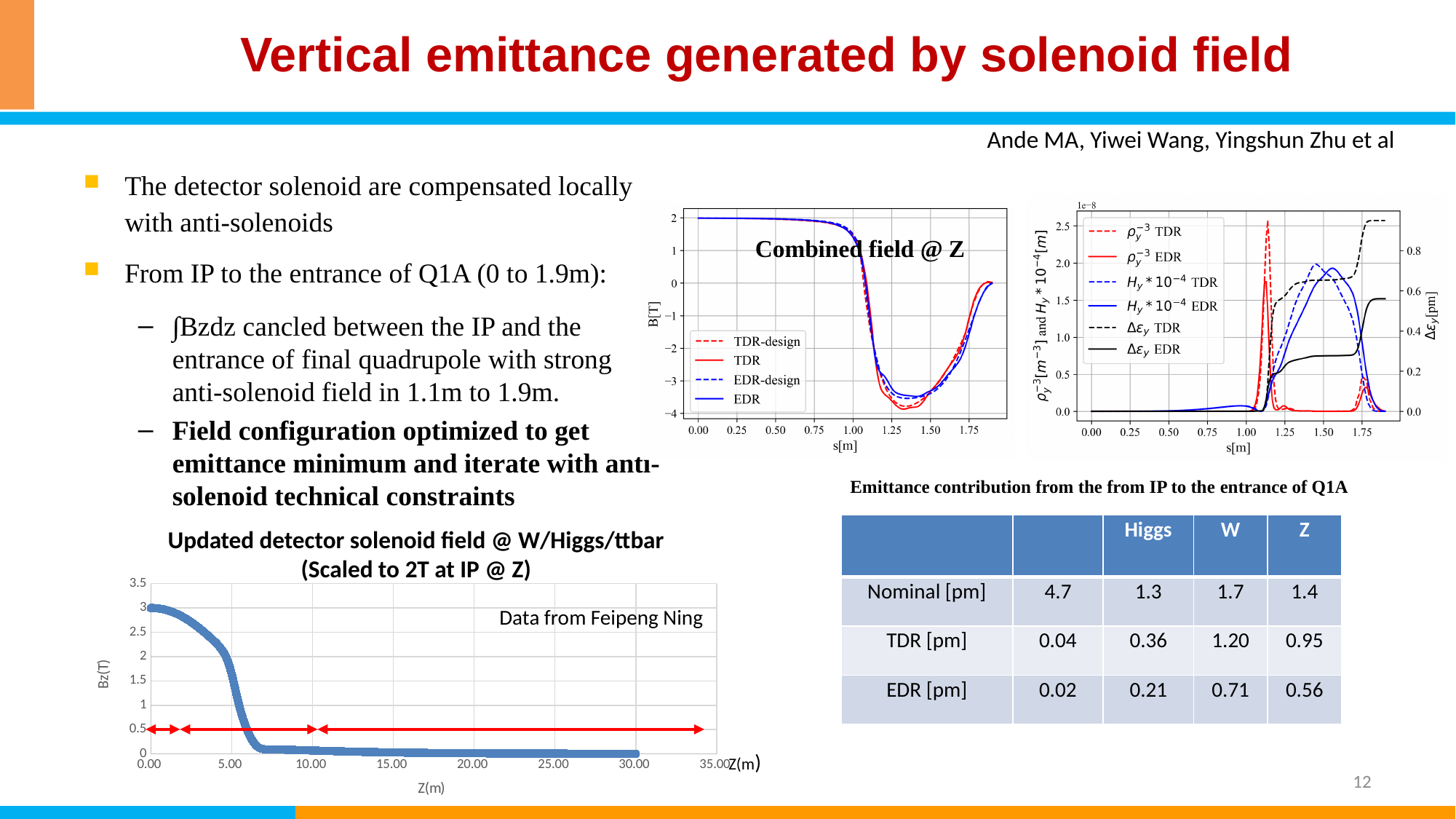
In the emittance chart on the right, is the value of Δεy TDR at s = 1.85 m greater or less than 0.8 pm? greater In the bottom-left chart 'Updated detector solenoid field @ W/Higgs/ttbar', does Bz rise or fall as Z increases from 0 to 10 m? fall In the bottom-left chart 'Updated detector solenoid field @ W/Higgs/ttbar', is Bz at Z = 5.00 m greater or less than 1.5 T? greater In the 'Combined field @ Z' chart, does B[T] rise or fall as s goes from 0 to 1.25 m? fall In the 'Combined field @ Z' chart, what are the legend entries? TDR-design, TDR, EDR-design, EDR In the bottom-left chart 'Updated detector solenoid field @ W/Higgs/ttbar', is Bz at Z = 10.00 m greater or less than 0.5 T? less In the emittance chart on the right (with Δεy on the right axis), how many series does the legend list? 6 In the 'Combined field @ Z' chart, what is the label of the y axis? B[T] In the 'Combined field @ Z' chart, what kind of chart is it? line chart In the emittance chart on the right, at s = 1.75 m, which is larger: Δεy TDR or Δεy EDR? Δεy TDR In the 'Combined field @ Z' chart, how many series does the legend list? 4